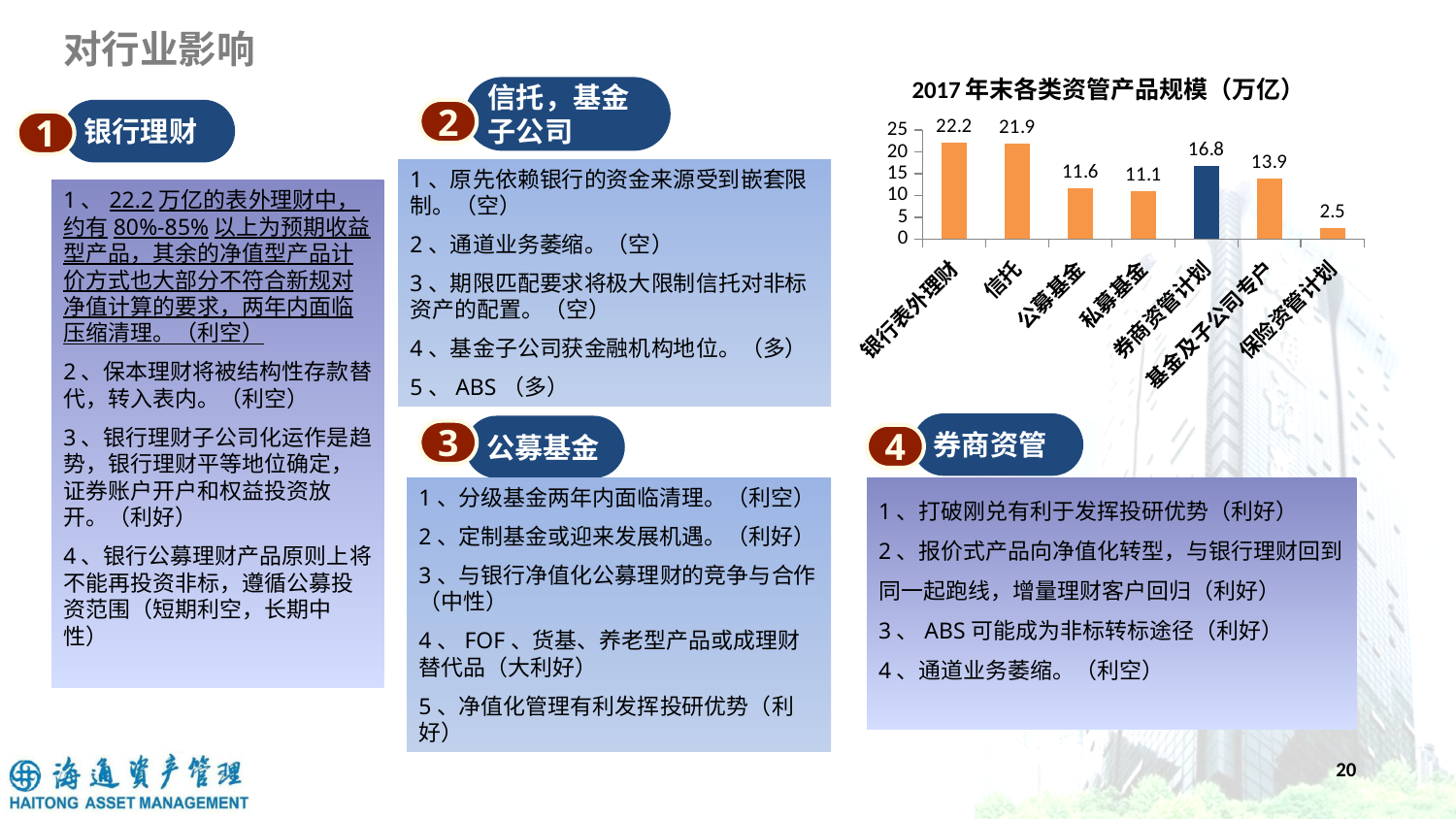
Which category has the highest value in the chart? 银行表外理财 What is the value for 保险资管计划 in the chart? 2.5 What is the difference between the values for 银行表外理财 and 信托? 0.3 What is the value for 券商资管计划 in the chart? 16.8 What kind of chart is shown on the slide? bar chart What is the difference between the values for 券商资管计划 and 基金及子公司专户? 2.9 Which is larger, the value for 公募基金 or the value for 私募基金? 公募基金 What is the title of the chart? 2017年末各类资管产品规模（万亿） How many categories are shown in the chart? 7 What is the value for 基金及子公司专户 in the chart? 13.9 What is the value for 银行表外理财 in the chart? 22.2 Which category has the lowest value in the chart? 保险资管计划